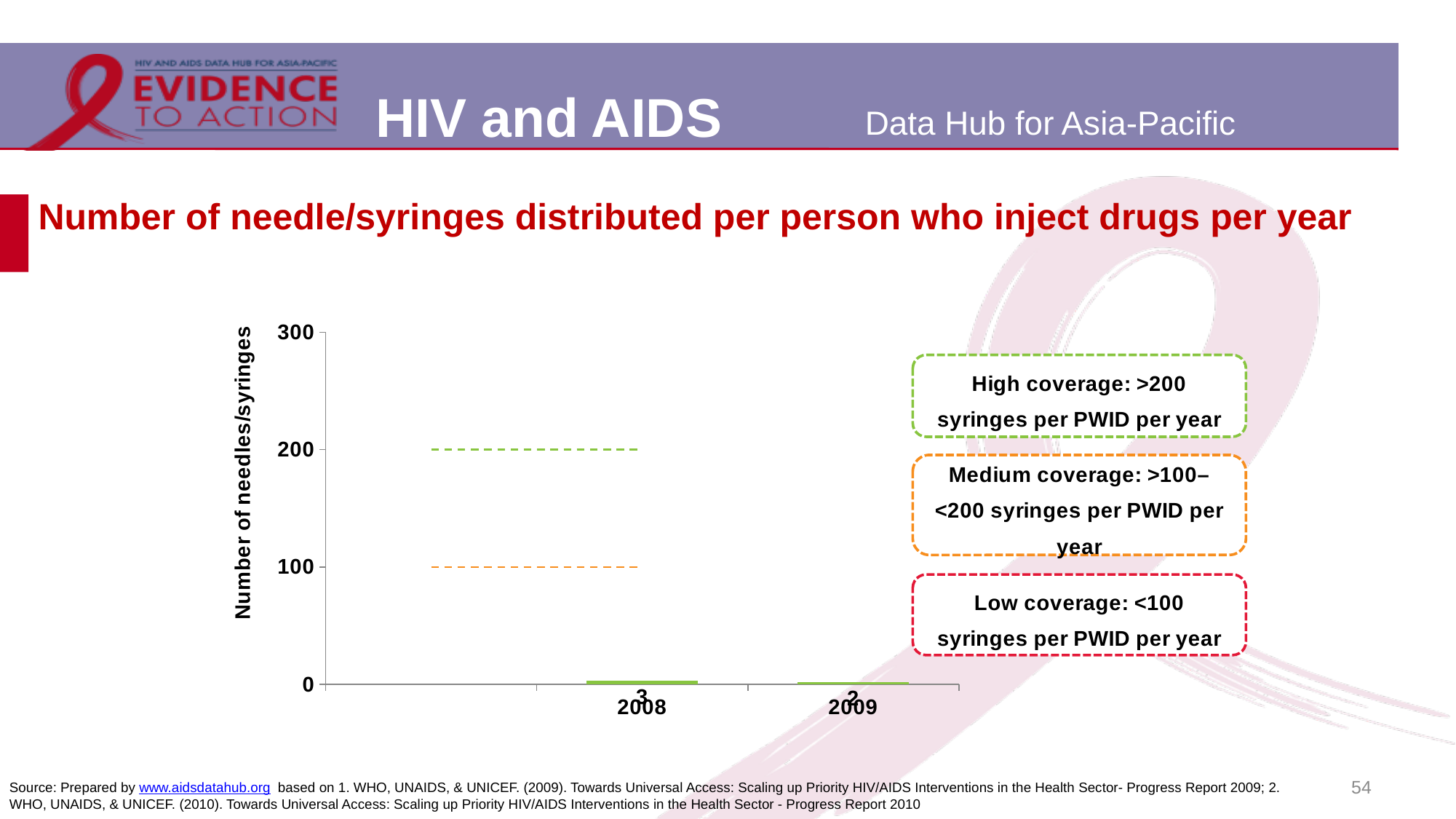
Is the value for 2008 greater or less than 100? less Is the value for 2009 greater or less than 100? less Which year has the higher number of needle/syringes distributed per person who injects drugs? 2008 Which year has the lower number of needle/syringes distributed per person who injects drugs? 2009 What is the label of the y axis of the chart? Number of needles/syringes What is the highest value shown on the y axis of the chart? 300 How many years are shown on the x axis of the chart? 2 What is the number of needle/syringes distributed per person who injects drugs in 2009? 2 Do the values rise or fall from 2008 to 2009? fall What is the difference between the 2008 and 2009 values for needle/syringes distributed per person who injects drugs? 1 What is the number of needle/syringes distributed per person who injects drugs in 2008? 3 What kind of chart is used to show the number of needle/syringes distributed per person who injects drugs? bar chart